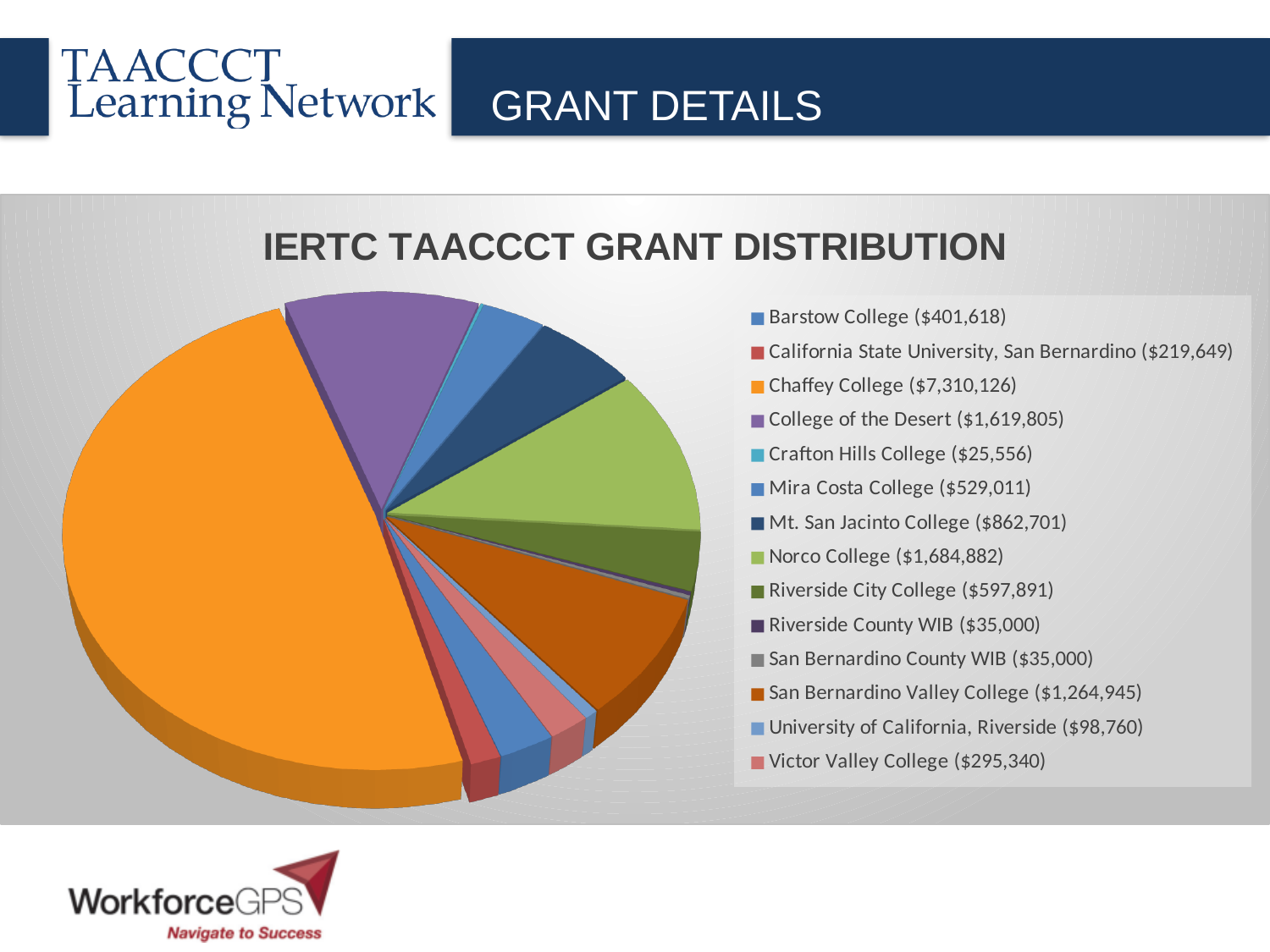
What is the difference between the grant amounts for Norco College and College of the Desert? $65,077 What is the grant amount for Norco College? $1,684,882 Which institution received the smallest grant amount? Crafton Hills College What is the grant amount for University of California, Riverside? $98,760 Which institution received the largest grant amount? Chaffey College What is the difference between the grant amounts for Mt. San Jacinto College and Riverside City College? $264,810 Which received a larger grant amount, Mira Costa College or Riverside City College? Riverside City College What is the grant amount for Mt. San Jacinto College? $862,701 What type of chart is shown on the slide? Pie chart What is the title of the chart? IERTC TAACCCT GRANT DISTRIBUTION What is the grant amount for Chaffey College? $7,310,126 How many categories does the pie chart's legend list? 14